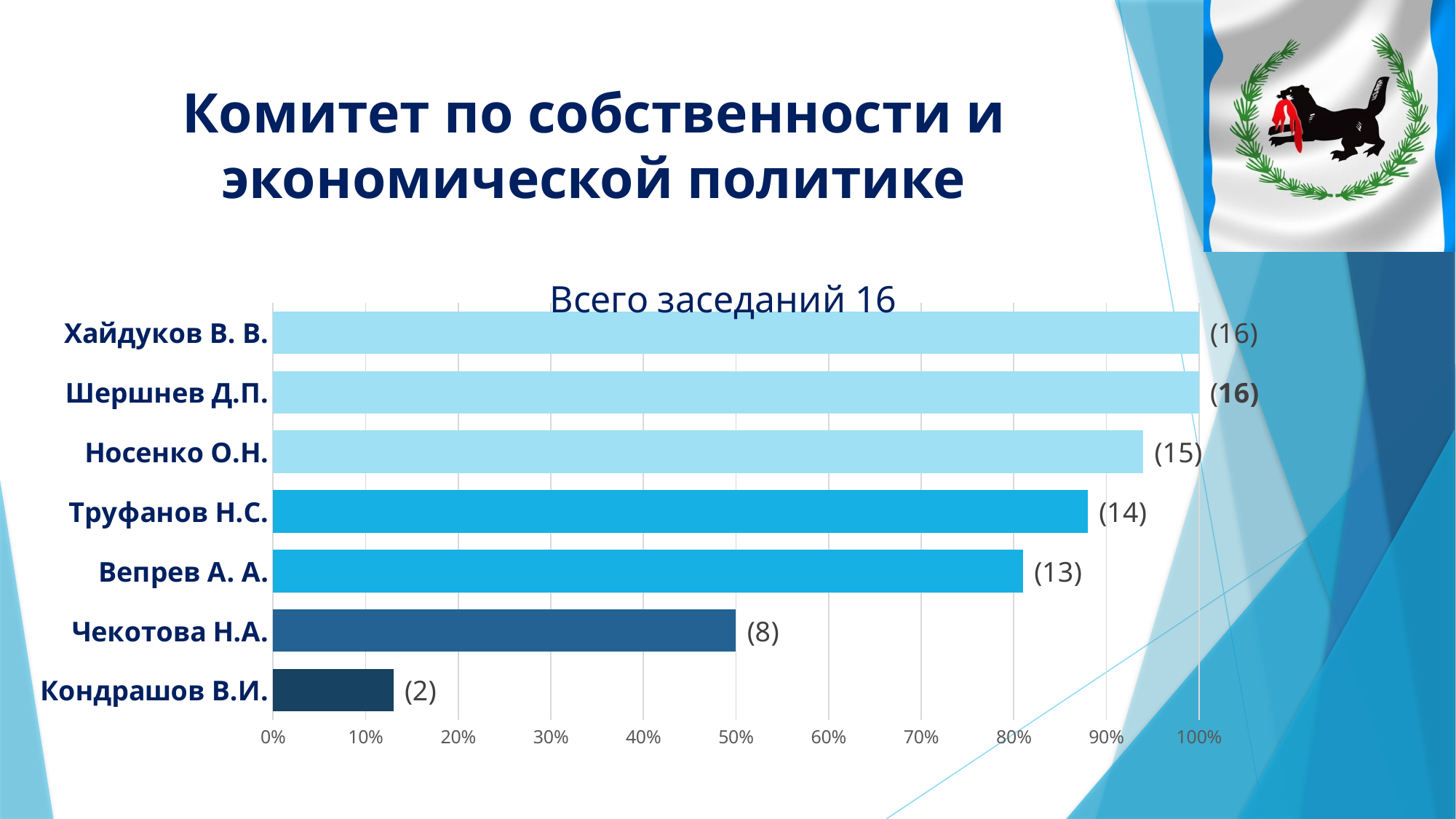
Which category has the lowest value? Кондрашов В.И. What is the data label for Носенко О.Н.? (15) What kind of chart is shown on the slide? bar chart Is the bar for Кондрашов В.И. greater or less than 20%? less What is the difference between the labelled values for Носенко О.Н. and Чекотова Н.А.? 7 What is the difference between the labelled values for Труфанов Н.С. and Кондрашов В.И.? 12 How many categories are shown in the chart? 7 What is the data label for Чекотова Н.А.? (8) What is the title of the chart? Всего заседаний 16